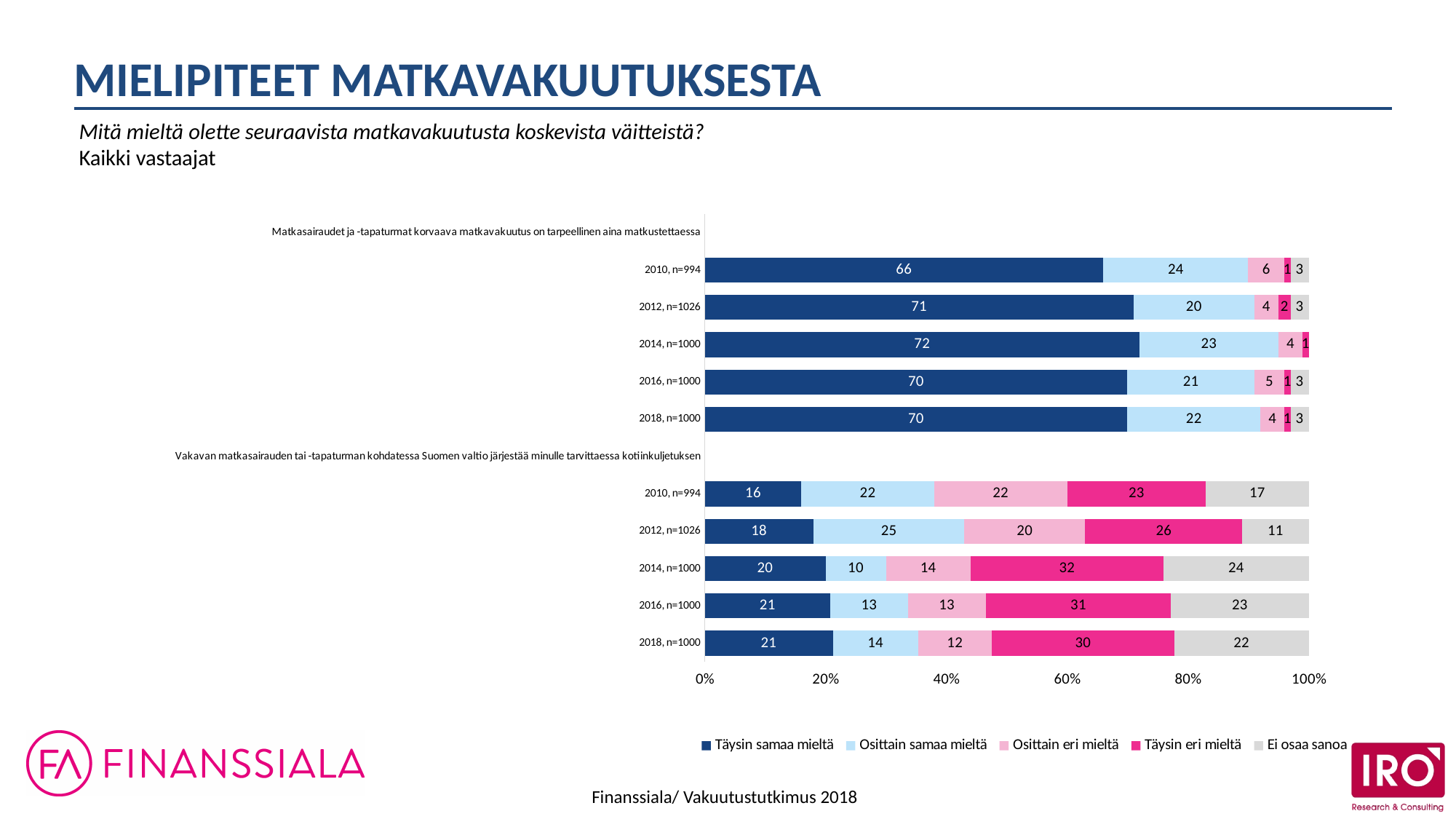
For the statement 'Matkasairaudet ja -tapaturmat korvaava matkavakuutus on tarpeellinen aina matkustettaessa', what is the difference in the 'Täysin samaa mieltä' value between 2012, n=1026 and 2010, n=994? 5 For the statement 'Vakavan matkasairauden tai -tapaturman kohdatessa Suomen valtio järjestää minulle tarvittaessa kotiinkuljetuksen', does the 'Täysin samaa mieltä' value rise or fall from 2010 to 2018? Rises For the statement 'Vakavan matkasairauden tai -tapaturman kohdatessa Suomen valtio järjestää minulle tarvittaessa kotiinkuljetuksen' in 2018, n=1000, which is larger: 'Täysin eri mieltä' or 'Ei osaa sanoa'? Täysin eri mieltä For the statement 'Vakavan matkasairauden tai -tapaturman kohdatessa Suomen valtio järjestää minulle tarvittaessa kotiinkuljetuksen', what is the 'Ei osaa sanoa' value for 2014, n=1000? 24 For the statement 'Vakavan matkasairauden tai -tapaturman kohdatessa Suomen valtio järjestää minulle tarvittaessa kotiinkuljetuksen', which year has the lowest 'Ei osaa sanoa' value? 2012, n=1026 For the statement 'Matkasairaudet ja -tapaturmat korvaava matkavakuutus on tarpeellinen aina matkustettaessa', what is the 'Täysin samaa mieltä' value for 2014, n=1000? 72 For the statement 'Matkasairaudet ja -tapaturmat korvaava matkavakuutus on tarpeellinen aina matkustettaessa', which year has the highest 'Täysin samaa mieltä' value? 2014, n=1000 For the statement 'Vakavan matkasairauden tai -tapaturman kohdatessa Suomen valtio järjestää minulle tarvittaessa kotiinkuljetuksen', what is the 'Osittain samaa mieltä' value for 2012, n=1026? 25 How many series does the legend list? 5 For the statement 'Vakavan matkasairauden tai -tapaturman kohdatessa Suomen valtio järjestää minulle tarvittaessa kotiinkuljetuksen', which year has the highest 'Täysin eri mieltä' value? 2014, n=1000 What kind of chart is shown on the slide? Stacked bar chart How many bars are plotted in the chart in total? 10